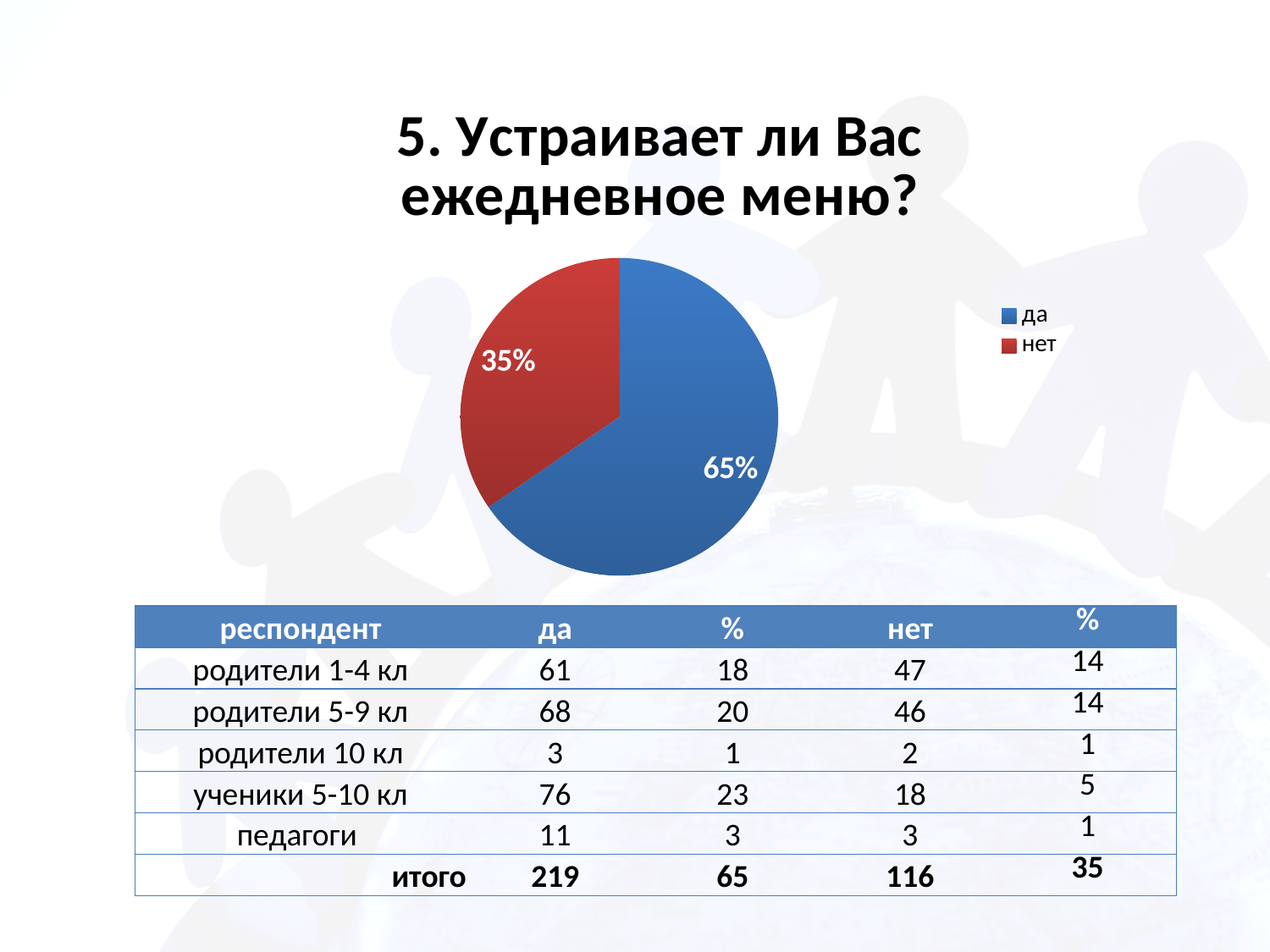
What share of the pie does the "да" slice represent? 65% How many slices does the pie chart have? 2 Which slice of the pie is the smallest? нет What is the difference in percentage points between the "да" and "нет" slices? 30 What colour is the "нет" slice in the pie chart? red Which slice of the pie is the largest? да Which is larger, the "да" slice or the "нет" slice? да What is the title of the chart? 5. Устраивает ли Вас ежедневное меню? How many entries does the legend list? 2 What share of the pie does the "нет" slice represent? 35% What kind of chart is shown on the slide? pie chart